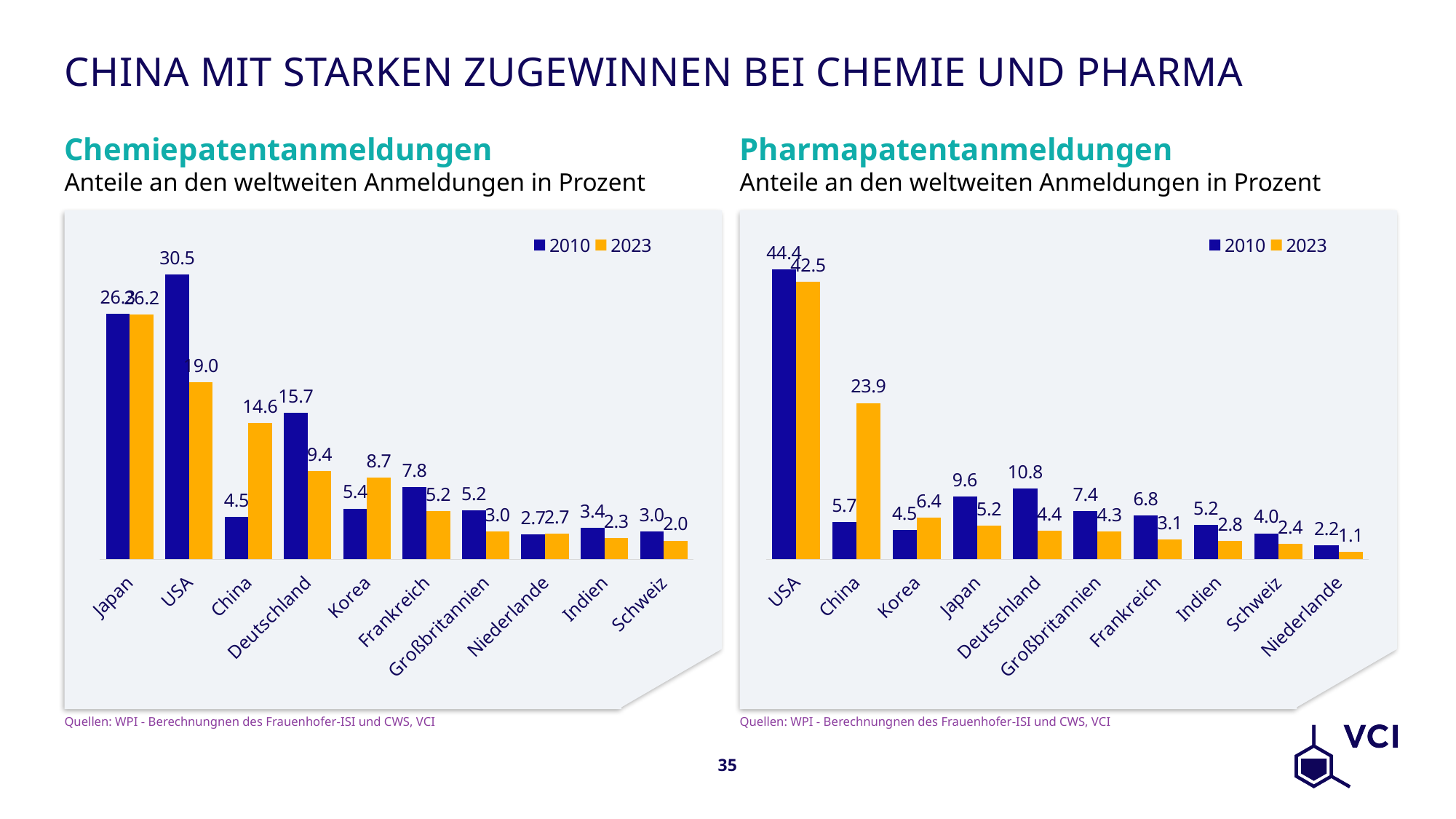
In the Chemiepatentanmeldungen chart, how many countries are shown on the x axis? 10 In the Pharmapatentanmeldungen chart, which country has the lowest 2023 value? Niederlande In the Chemiepatentanmeldungen chart, what is the difference between the 2010 and 2023 values for Deutschland? 6.3 In the Chemiepatentanmeldungen chart, what is the value for China in 2023? 14.6 In the Pharmapatentanmeldungen chart, what is the difference between the 2010 and 2023 values for USA? 1.9 In the Pharmapatentanmeldungen chart, what is the value for Deutschland in 2010? 10.8 In the Chemiepatentanmeldungen chart, which is larger for Korea: the 2010 value or the 2023 value? 2023 In the Chemiepatentanmeldungen chart, what is the value for USA in 2010? 30.5 How many series does the legend of the Pharmapatentanmeldungen chart list? 2 What type of chart is the Pharmapatentanmeldungen chart? Bar chart In the Pharmapatentanmeldungen chart, what is the value for China in 2023? 23.9 In the Chemiepatentanmeldungen chart, which country has the highest 2010 value? USA